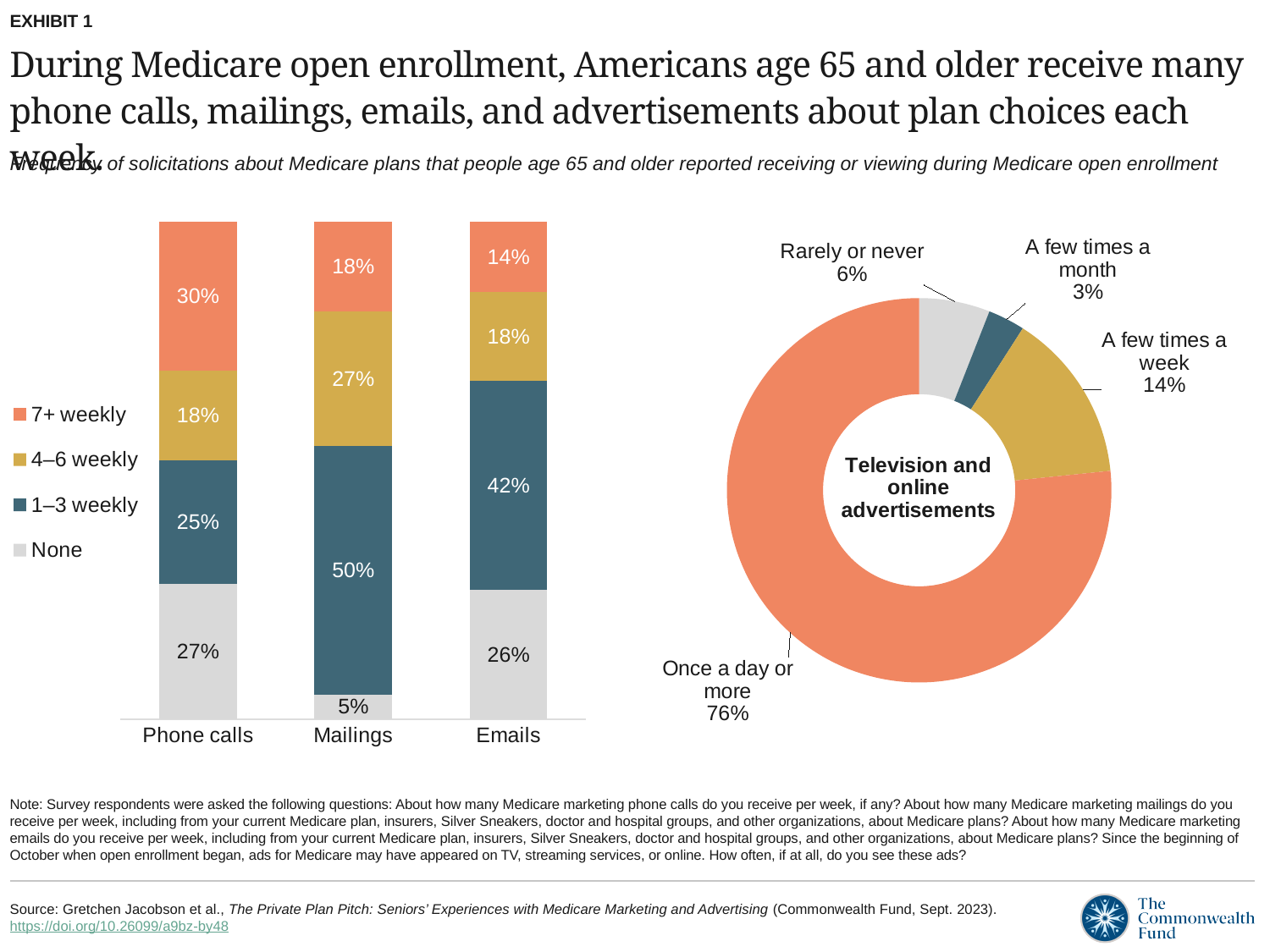
In the stacked bar chart on the left, what percentage of respondents reported receiving 1–3 weekly mailings? 50% In the stacked bar chart on the left, what percentage of respondents reported receiving 7+ weekly phone calls? 30% In the 'Television and online advertisements' donut chart, which slice is the smallest? A few times a month In the 'Television and online advertisements' donut chart, what share of respondents see ads once a day or more? 76% In the stacked bar chart on the left, what is the difference between the '1–3 weekly' share for Emails and for Phone calls? 17% In the stacked bar chart on the left, which category has the highest '7+ weekly' share? Phone calls In the stacked bar chart on the left, what percentage of respondents reported receiving no emails (None)? 26% In the stacked bar chart on the left, is the '4–6 weekly' share larger for Mailings or for Phone calls? Mailings What type of chart is the 'Television and online advertisements' chart on the right? Donut (pie) chart How many series does the legend of the stacked bar chart on the left list? 4 In the stacked bar chart on the left, which category has the lowest 'None' share? Mailings How many categories are shown on the x axis of the stacked bar chart on the left? 3